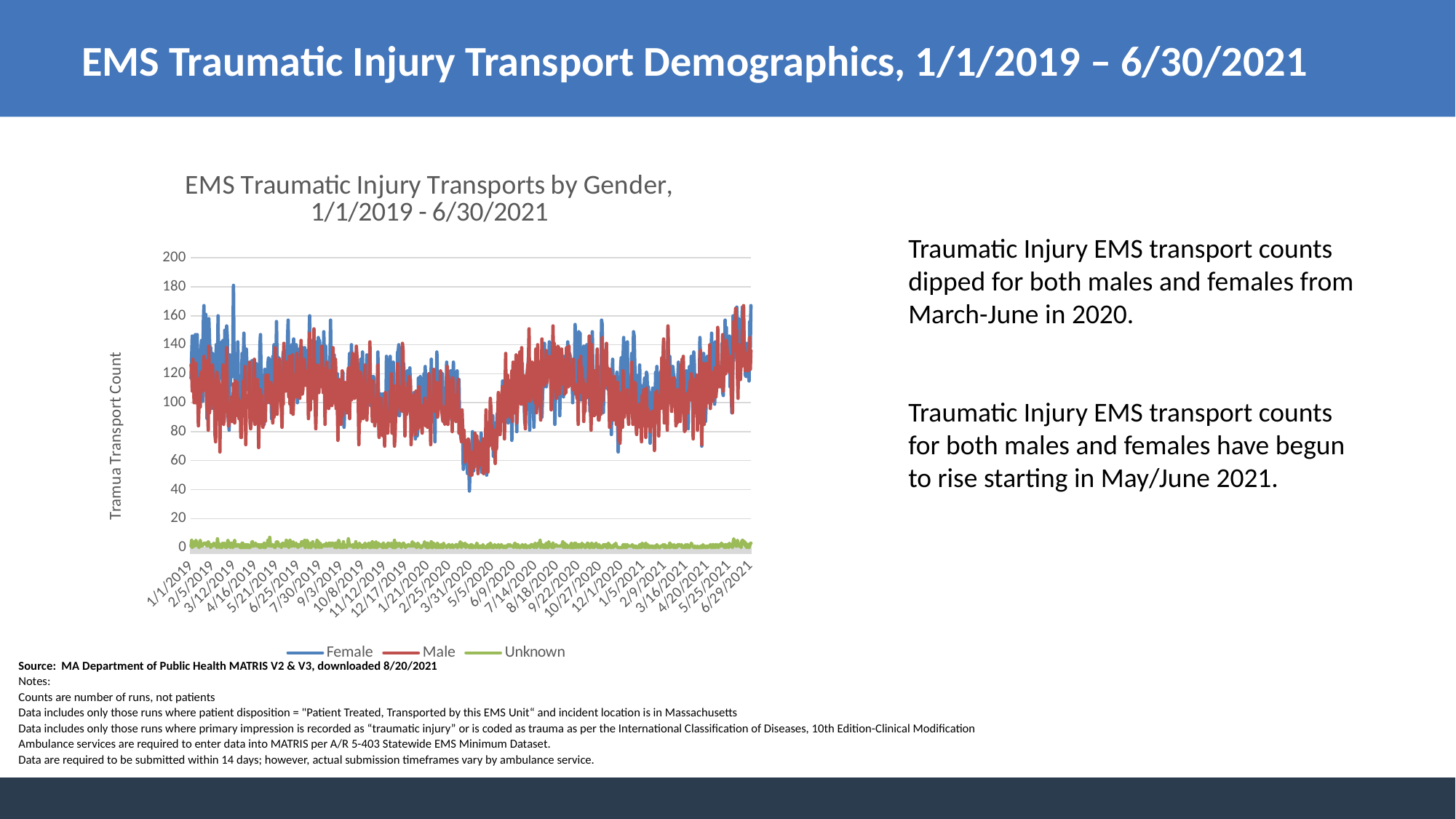
Which series has the lowest values throughout the chart? Unknown Do the Male and Female transport counts rise or fall between 2/25/2020 and 3/31/2020? fall How many series does the legend of the chart list? 3 Is the value for the Unknown series on 6/29/2021 greater or less than 20? less What kind of chart is shown on the slide? Line chart What are the three series named in the chart legend? Female, Male, Unknown Is the value for the Female series on 1/1/2019 greater or less than 60? greater Which is larger on 1/1/2019, the Male value or the Unknown value? Male Do the Male and Female transport counts rise or fall between 5/5/2020 and 7/14/2020? rise What is the title of the chart? EMS Traumatic Injury Transports by Gender, 1/1/2019 - 6/30/2021 Is the value for the Unknown series on 1/1/2019 greater or less than 20? less What is the highest value shown on the y axis of the chart? 200